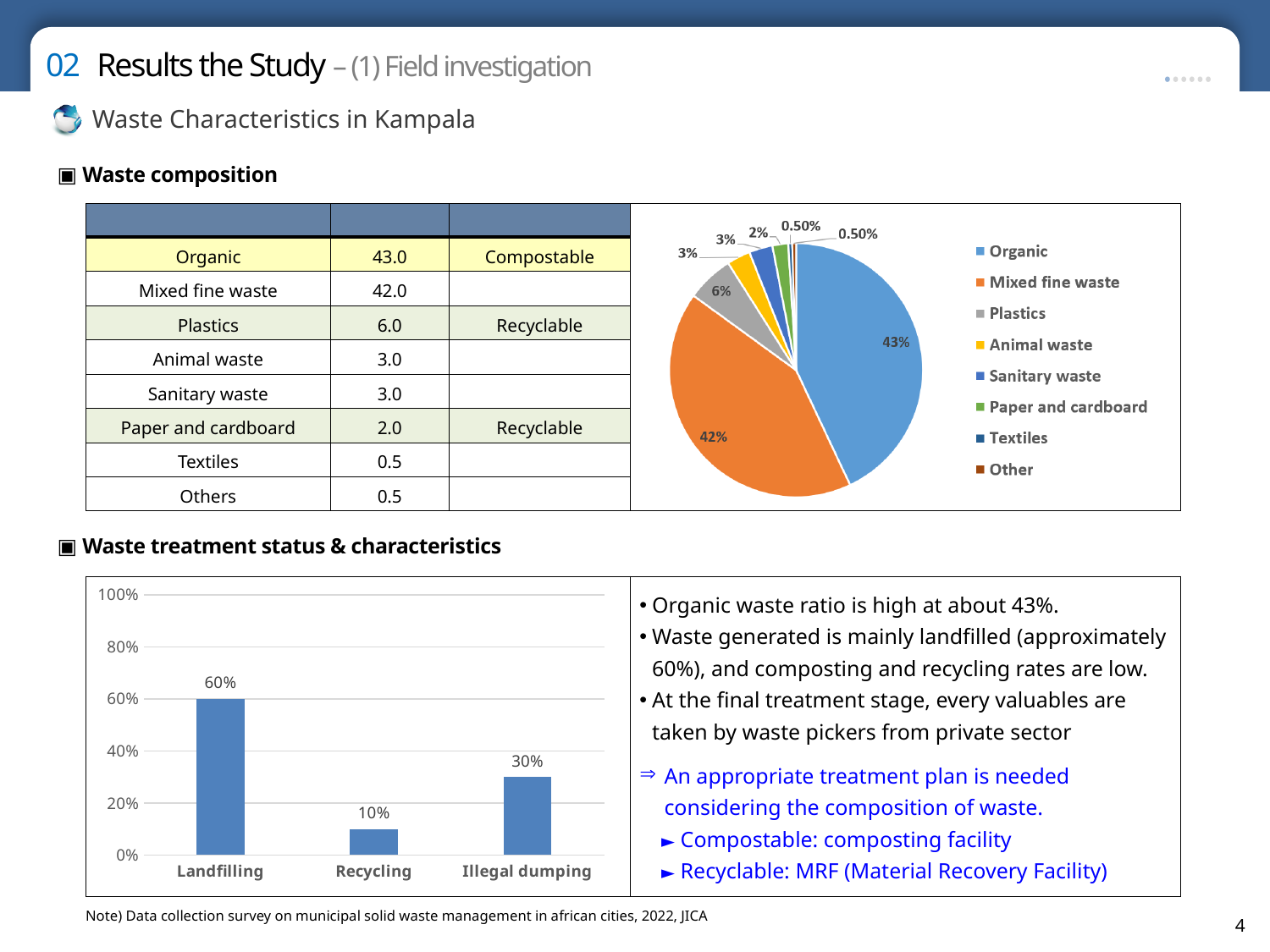
In the bar chart at the bottom left, what is the difference between Landfilling and Illegal dumping? 30% In the bar chart at the bottom left, which category has the lowest value? Recycling In the bar chart at the bottom left, how many categories are shown on the x axis? 3 In the pie chart, what share of waste is Plastics? 6% In the pie chart, what share of waste is Mixed fine waste? 42% What kind of chart is shown at the bottom left of the slide? Bar chart In the pie chart, what is the difference between the Organic and Plastics shares? 37% In the pie chart, what share of waste is Organic? 43% In the bar chart at the bottom left, what is the value for Recycling? 10% How many entries does the legend of the pie chart list? 8 In the bar chart at the bottom left, what is the value for Landfilling? 60% In the pie chart, which category has the largest slice? Organic